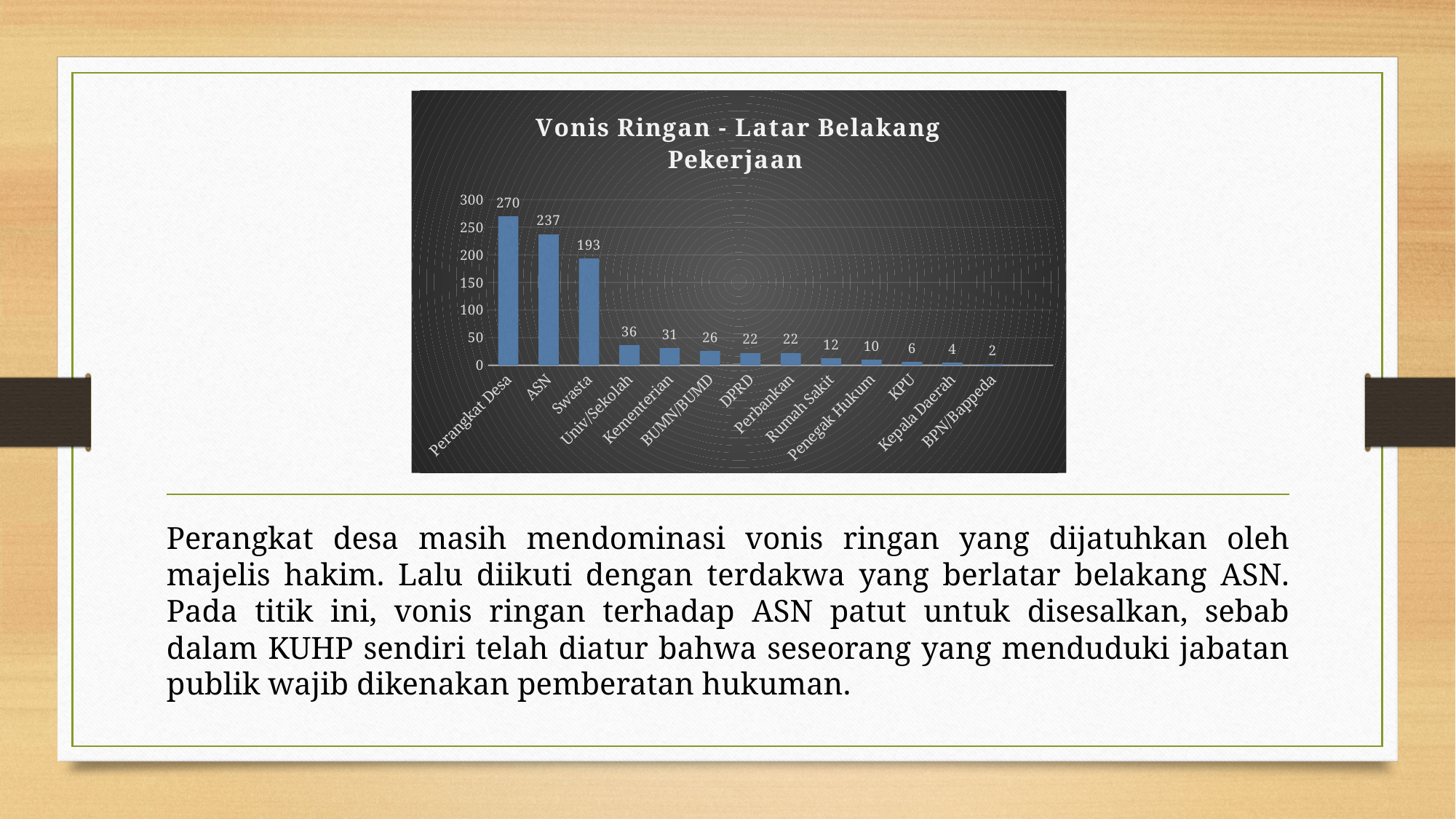
What kind of chart is shown on the slide? bar chart What is the value for Perangkat Desa? 270 What is the value for Swasta? 193 What is the title of the chart? Vonis Ringan - Latar Belakang Pekerjaan What is the value for Kementerian? 31 How many categories are shown on the x axis? 13 Is the value for Swasta greater or less than 150? greater Which category has the highest value? Perangkat Desa Which category has the lowest value? BPN/Bappeda What is the difference between the values for Perangkat Desa and ASN? 33 Which is larger, the value for Univ/Sekolah or the value for BUMN/BUMD? Univ/Sekolah What is the value for ASN? 237